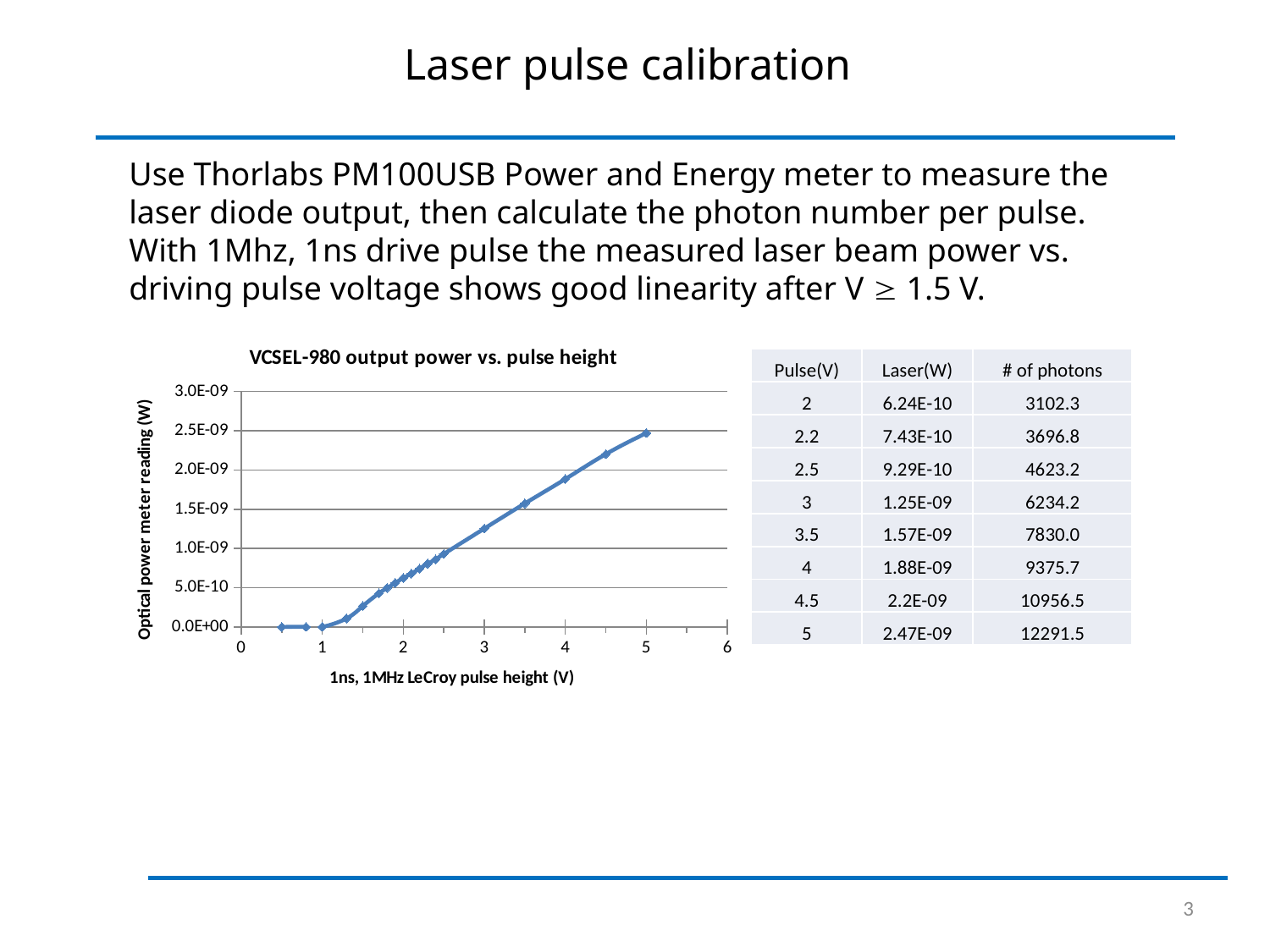
Is the optical power meter reading at a pulse height of 3 V greater or less than 1.0E-09? greater Is the optical power meter reading at a pulse height of 1 V greater or less than 5.0E-10? less What is the title of the chart? VCSEL-980 output power vs. pulse height Which has the larger optical power meter reading: a pulse height of 2 V or 5 V? 5 V Is the optical power meter reading at a pulse height of 5 V greater or less than 2.0E-09? greater What kind of chart is shown on the slide? line chart Does the optical power meter reading rise or fall as the pulse height increases from 1 V to 5 V? rise At which pulse height is the optical power meter reading highest? 5 V What is the label of the y axis of the chart? Optical power meter reading (W)